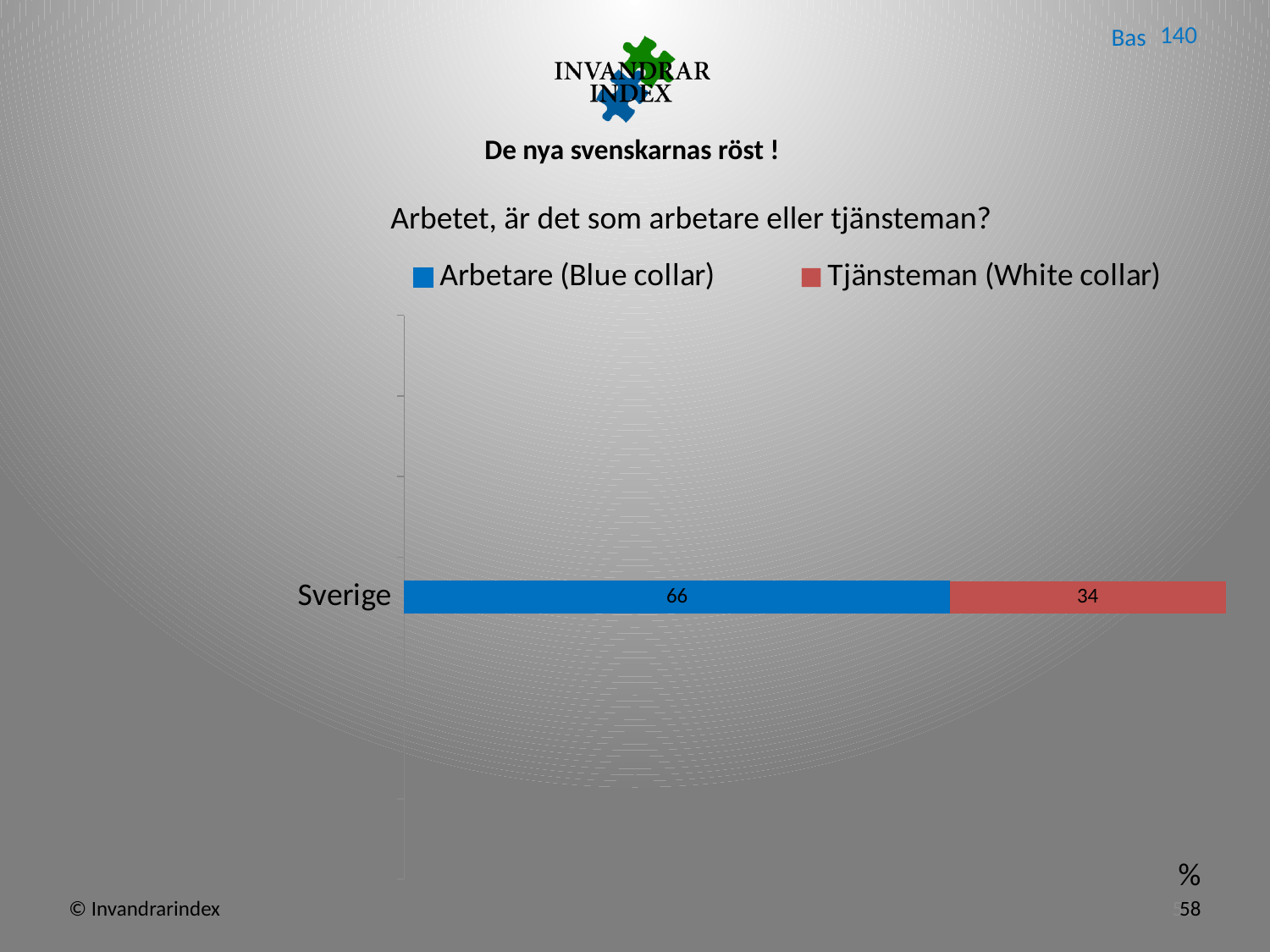
How many categories are shown on the chart? 1 What is the difference between the Arbetare (Blue collar) and Tjänsteman (White collar) values for Sverige? 32 What is the value for Tjänsteman (White collar) for Sverige? 34 What kind of chart is shown on the slide? Stacked bar chart What is the title of the chart? Arbetet, är det som arbetare eller tjänsteman? What is the total of the stacked bar for Sverige? 100 Which series has the larger value for Sverige, Arbetare (Blue collar) or Tjänsteman (White collar)? Arbetare (Blue collar) What is the value for Arbetare (Blue collar) for Sverige? 66 How many series does the legend list? 2 Which colour represents Tjänsteman (White collar) in the chart? Red What is the name of the only category on the chart? Sverige